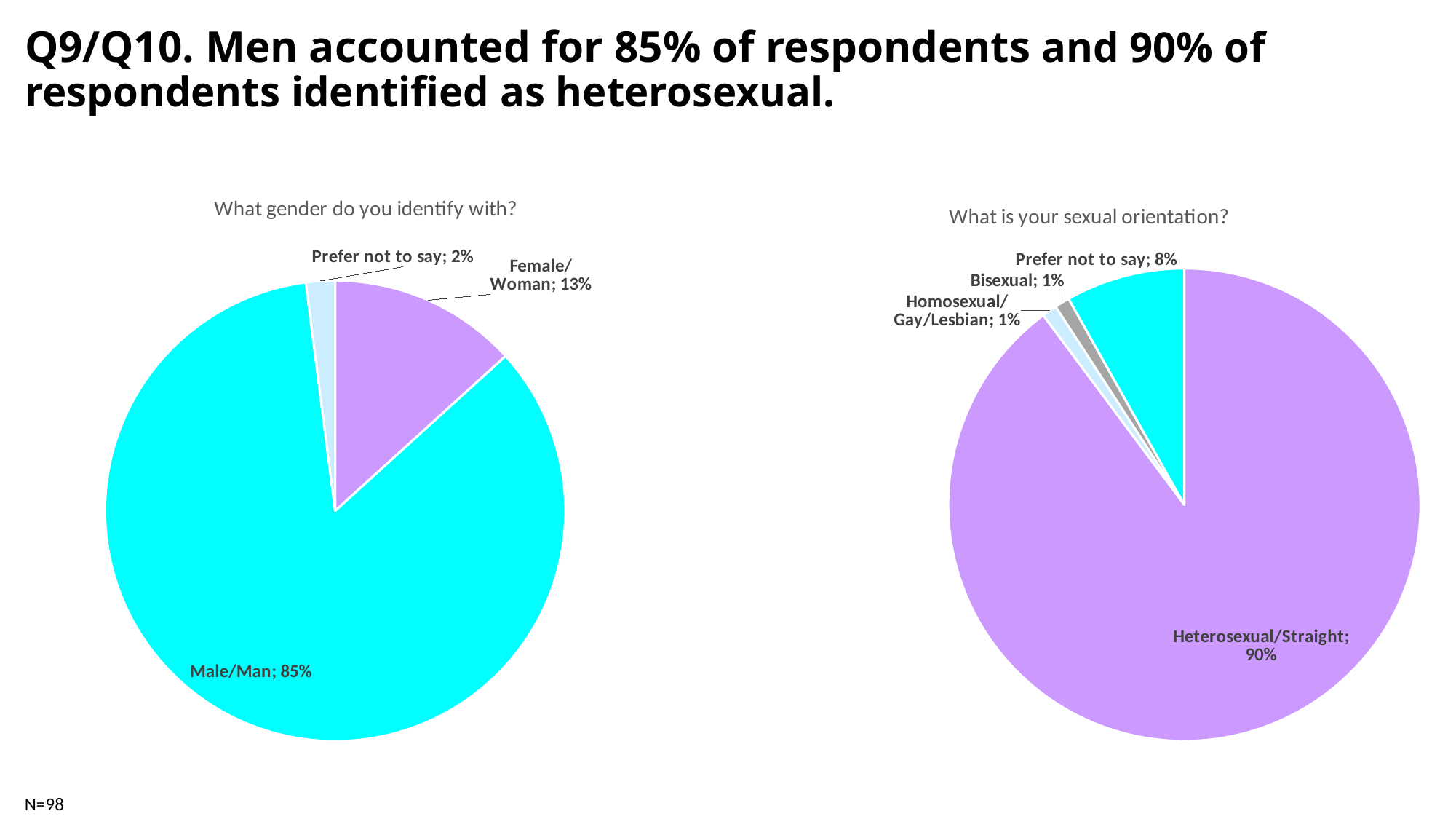
In the 'What gender do you identify with?' chart, what share of respondents identified as Male/Man? 85% In the 'What is your sexual orientation?' chart, what share of respondents identified as Bisexual? 1% In the 'What gender do you identify with?' chart, what share of respondents identified as Female/Woman? 13% In the 'What gender do you identify with?' chart, which category has the largest slice? Male/Man What type of chart is used for 'What gender do you identify with?'? Pie chart In the 'What gender do you identify with?' chart, what is the difference between the Male/Man and Female/Woman shares? 72 percentage points In the 'What is your sexual orientation?' chart, which category has the largest slice? Heterosexual/Straight In the 'What gender do you identify with?' chart, which category has the smallest slice? Prefer not to say In the 'What is your sexual orientation?' chart, what share of respondents identified as Heterosexual/Straight? 90% In the 'What gender do you identify with?' chart, what share of respondents chose 'Prefer not to say'? 2% How many categories are shown in the 'What is your sexual orientation?' chart? 4 In the 'What is your sexual orientation?' chart, what share of respondents chose 'Prefer not to say'? 8%